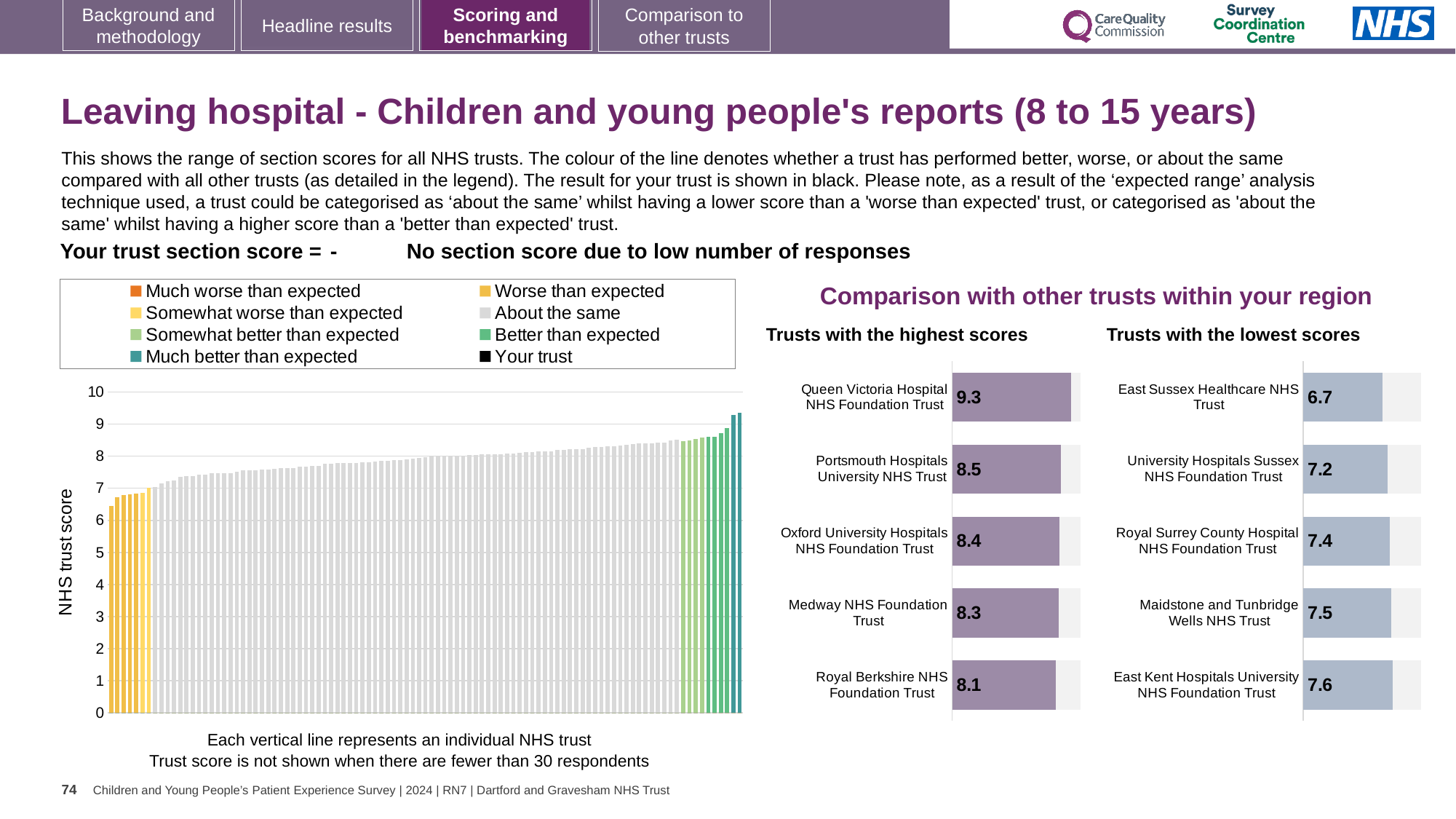
In the 'Trusts with the highest scores' chart, what is the score for Queen Victoria Hospital NHS Foundation Trust? 9.3 In the 'Trusts with the lowest scores' chart, what is the score for Royal Surrey County Hospital NHS Foundation Trust? 7.4 In the 'Trusts with the lowest scores' chart, which trust has the lowest score? East Sussex Healthcare NHS Trust In the 'Trusts with the lowest scores' chart, which has the higher score: University Hospitals Sussex NHS Foundation Trust or Maidstone and Tunbridge Wells NHS Trust? Maidstone and Tunbridge Wells NHS Trust In the 'Trusts with the highest scores' chart, which trust has the lowest score shown? Royal Berkshire NHS Foundation Trust How many trusts are listed in the 'Trusts with the highest scores' chart? 5 In the NHS trust score chart on the left, is the value of the leftmost bar greater or less than 7? less How many entries does the legend of the NHS trust score chart on the left list? 8 What kind of chart is the NHS trust score chart on the left of the slide? Bar chart In the NHS trust score chart on the left, do the bar values rise or fall from left to right? Rise In the 'Trusts with the highest scores' chart, what is the difference between the scores of Queen Victoria Hospital NHS Foundation Trust and Portsmouth Hospitals University NHS Trust? 0.8 In the 'Trusts with the lowest scores' chart, what is the difference between the scores of East Kent Hospitals University NHS Foundation Trust and East Sussex Healthcare NHS Trust? 0.9